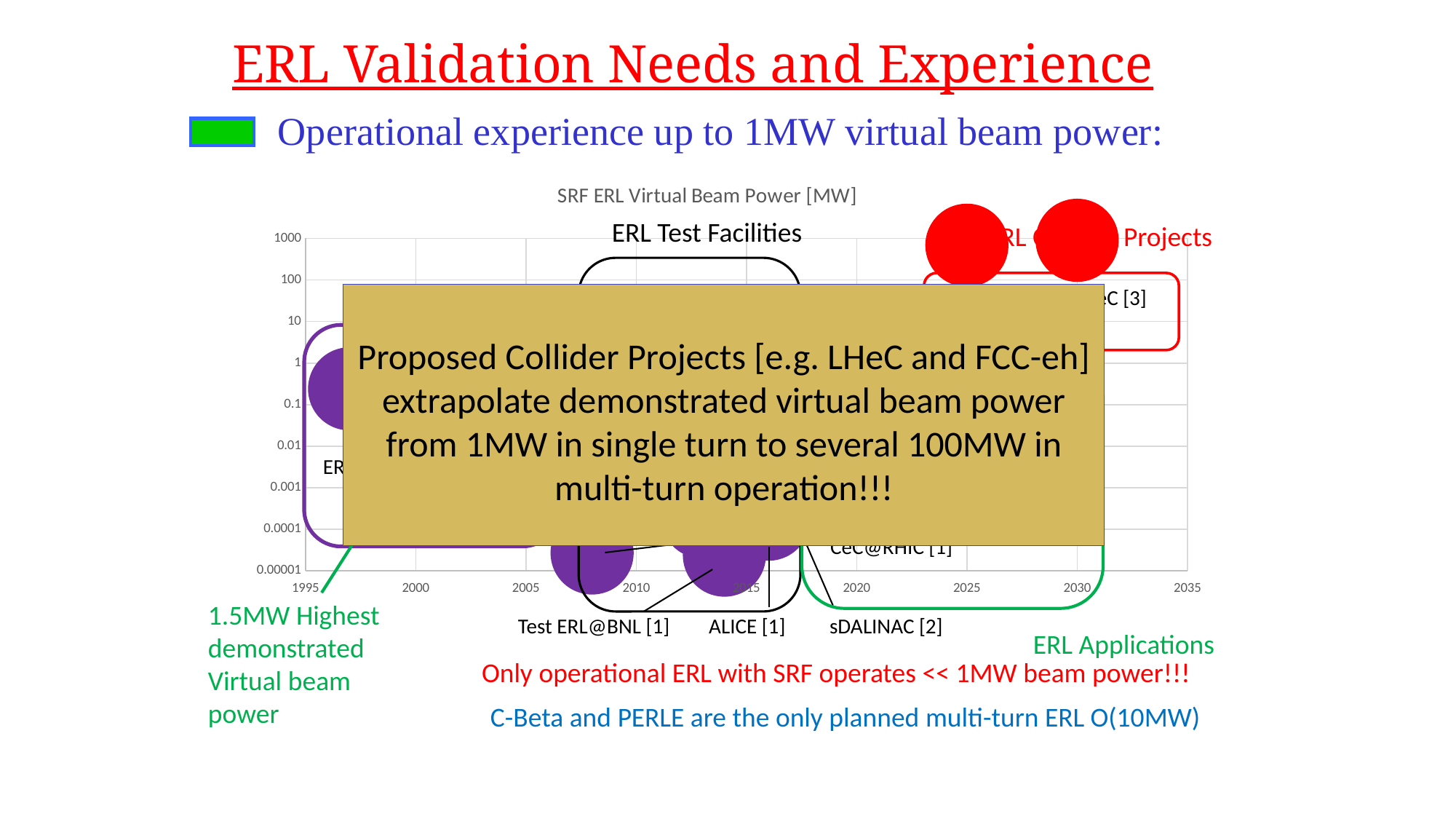
What is the title of the chart? SRF ERL Virtual Beam Power [MW] Is the virtual beam power for the red ERL Collider Projects bubbles greater or less than 100? greater What is the earliest year shown on the chart's x axis? 1995 How many year tick labels are shown on the chart's x axis? 9 Is the virtual beam power for ALICE [1] greater or less than 0.001? less What kind of chart is shown on the slide? Bubble (scatter) chart What is the latest year shown on the chart's x axis? 2035 Which has the higher virtual beam power on the chart: the red ERL Collider Projects bubbles or the Test ERL@BNL [1] bubble? ERL Collider Projects Is the virtual beam power for Test ERL@BNL [1] greater or less than 0.001? less What is the highest value shown on the chart's y axis? 1000